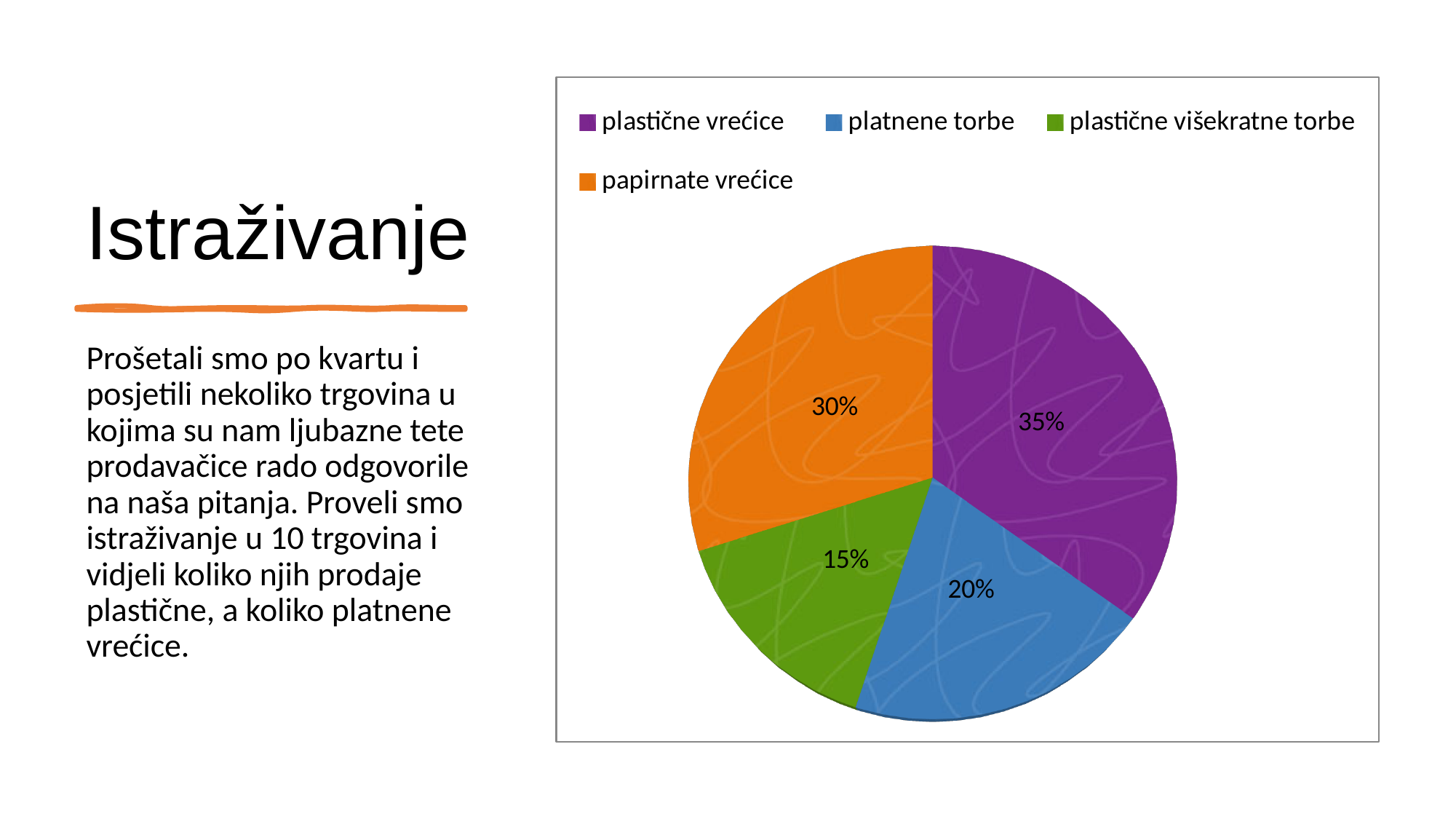
What share of the pie does 'platnene torbe' have? 20% What is the difference in percentage points between 'plastične vrećice' and 'papirnate vrećice'? 5% What share of the pie does 'plastične višekratne torbe' have? 15% Which category has the largest slice of the pie? plastične vrećice What is the difference in percentage points between 'platnene torbe' and 'plastične višekratne torbe'? 5% How many slices does the pie chart have? 4 What share of the pie does 'plastične vrećice' have? 35% Which category has the smallest slice of the pie? plastične višekratne torbe What colour is the slice for 'papirnate vrećice'? orange What type of chart is shown on the slide? pie chart Which is larger, the slice for 'papirnate vrećice' or the slice for 'platnene torbe'? papirnate vrećice